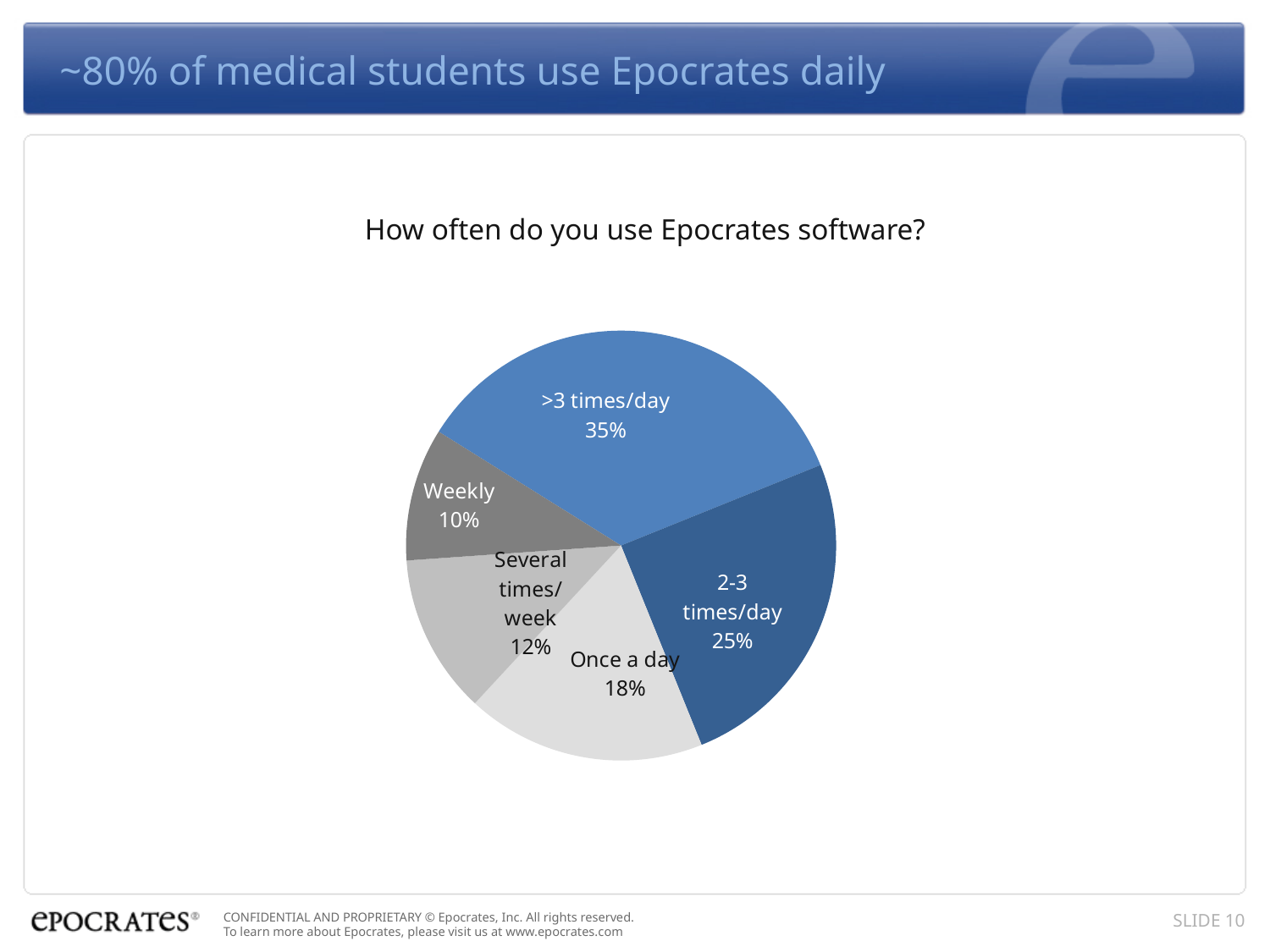
What percentage of respondents use Epocrates several times/week? 12% What percentage of respondents use Epocrates weekly? 10% Which category has the smallest share of the pie? Weekly What is the chart's title? How often do you use Epocrates software? What percentage of respondents use Epocrates once a day? 18% What kind of chart is shown on the slide? pie chart Which category has the largest share of the pie? >3 times/day How many slices does the pie chart have? 5 Which is larger, the Once a day slice or the Several times/week slice? Once a day What percentage of respondents use Epocrates >3 times/day? 35% What is the difference in percentage points between the >3 times/day slice and the 2-3 times/day slice? 10 What percentage of respondents use Epocrates 2-3 times/day? 25%